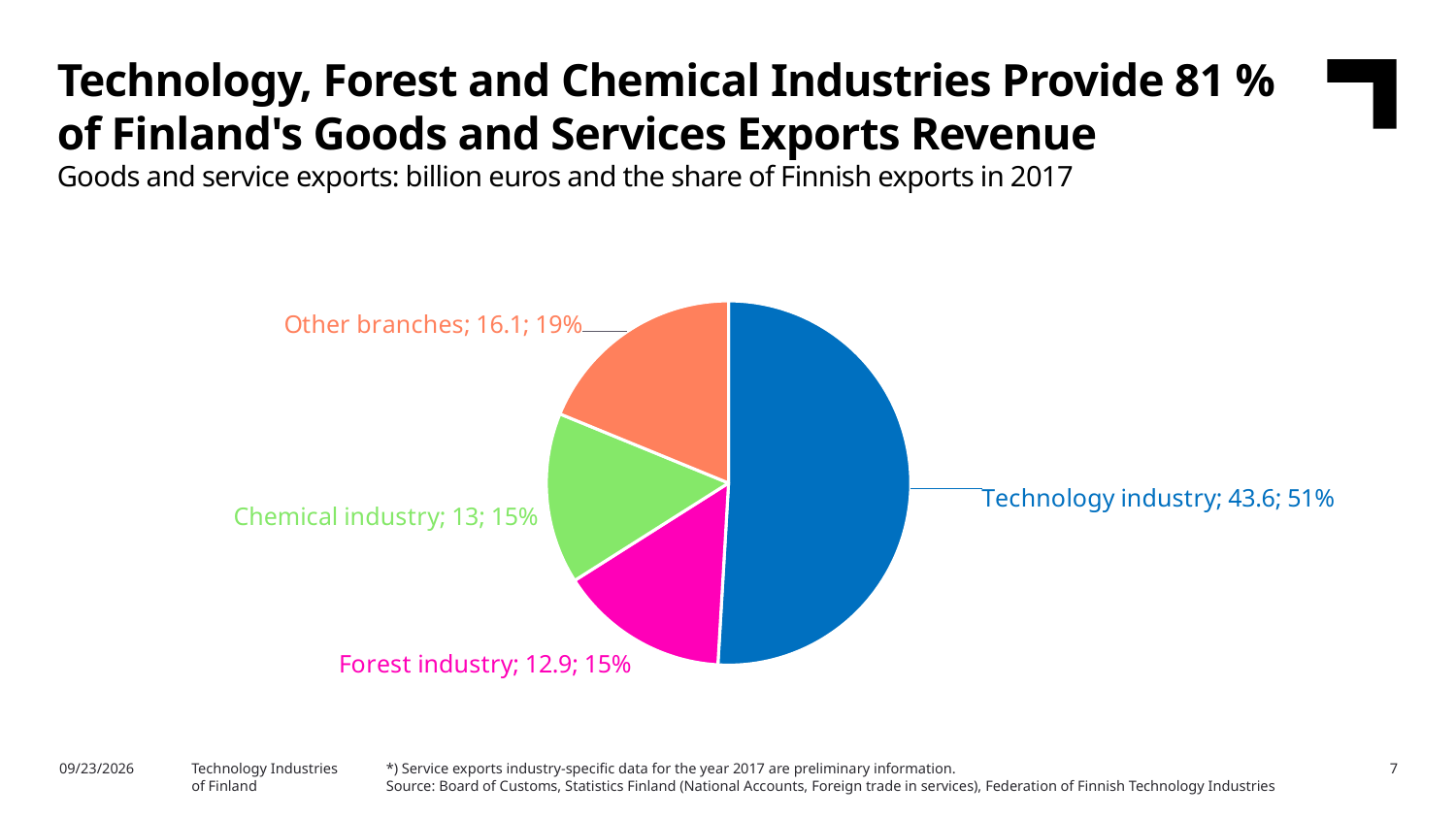
What is the value in billion euros for Other branches? 16.1 What is the difference in billion euros between the Technology industry and Other branches? 27.5 What is the value in billion euros for the Chemical industry? 13 Which category has the largest slice of the pie? Technology industry What is the value in billion euros for the Technology industry? 43.6 What colour is the Forest industry slice? Magenta (pink) What is the value in billion euros for the Forest industry? 12.9 How many slices does the pie chart have? 4 Which is larger, the Technology industry or Other branches? Technology industry What type of chart is shown on the slide? Pie chart What share of Finnish exports do Other branches account for? 19% What share of Finnish exports does the Technology industry account for? 51%